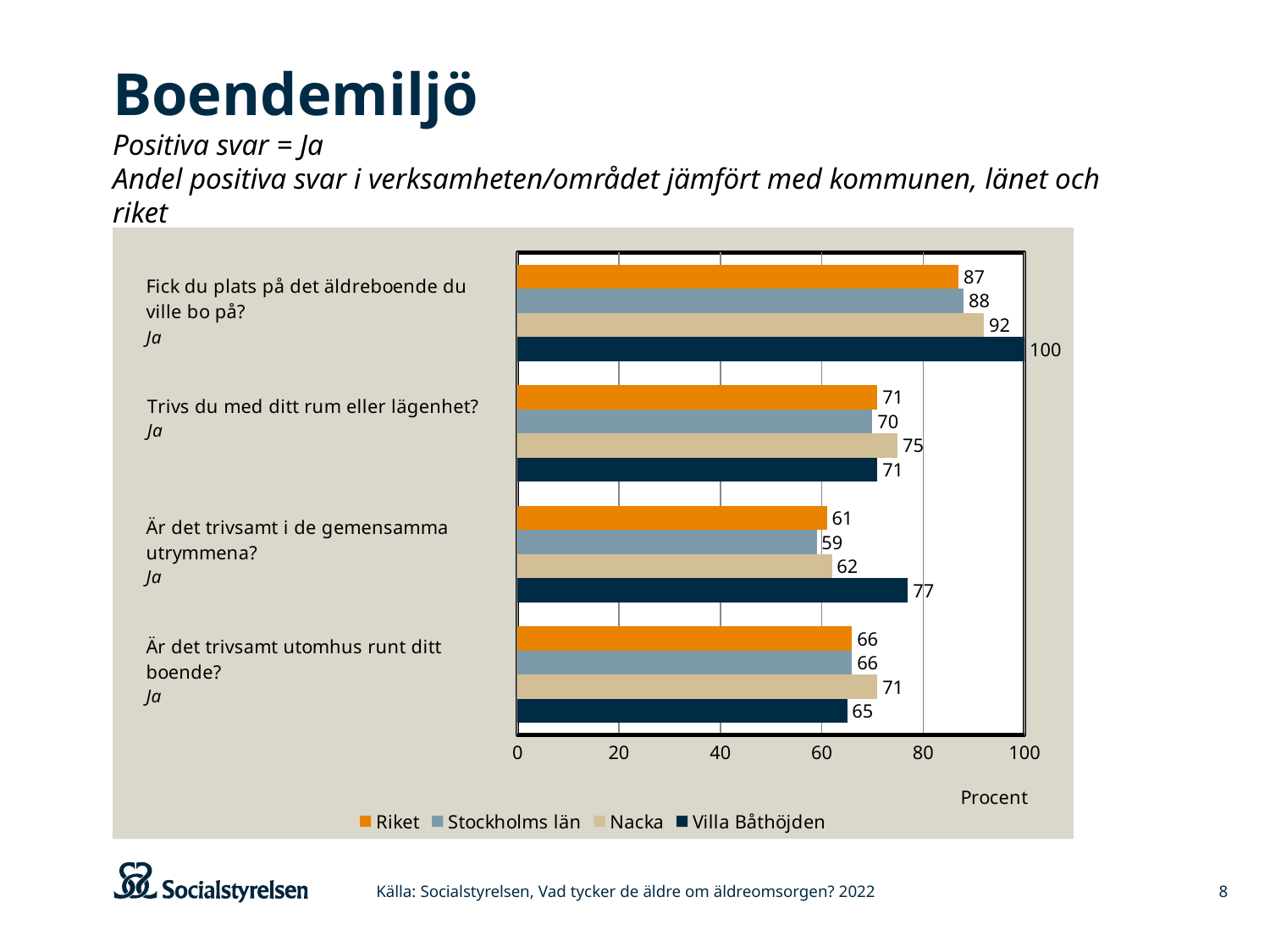
Which series has the highest value for the question "Är det trivsamt i de gemensamma utrymmena?"? Villa Båthöjden What is the label on the horizontal axis of the chart? Procent Which series has the lowest value for the question "Är det trivsamt utomhus runt ditt boende?"? Villa Båthöjden What is the difference between the Villa Båthöjden value and the Riket value for the question "Är det trivsamt i de gemensamma utrymmena?"? 16 What is the value for Villa Båthöjden for the question "Fick du plats på det äldreboende du ville bo på?"? 100 What is the value for Nacka for the question "Trivs du med ditt rum eller lägenhet?"? 75 How many questions (categories) are shown on the chart? 4 How many series does the legend list? 4 What is the value for Riket for the question "Är det trivsamt utomhus runt ditt boende?"? 66 What is the value for Stockholms län for the question "Är det trivsamt i de gemensamma utrymmena?"? 59 For the question "Fick du plats på det äldreboende du ville bo på?", which is larger: the value for Nacka or the value for Stockholms län? Nacka What kind of chart is shown on the slide? Bar chart